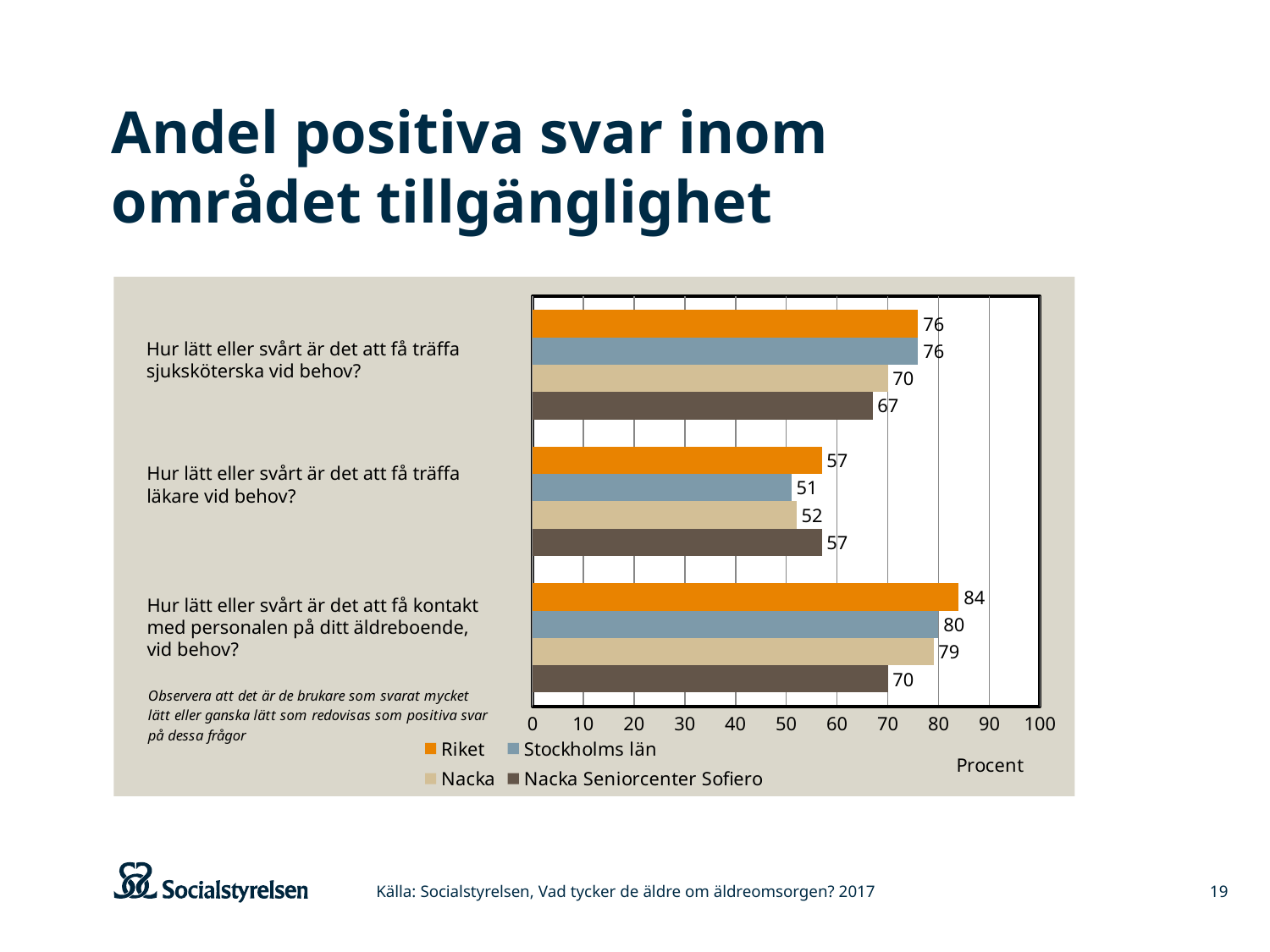
What is the value for Nacka Seniorcenter Sofiero on the question about meeting a nurse when needed ("...träffa sjuksköterska vid behov?")? 67 What is the value for Stockholms län on the question about meeting a doctor when needed ("...träffa läkare vid behov?")? 51 What is the value for Riket on the question about getting in contact with staff at the care home ("Hur lätt eller svårt är det att få kontakt med personalen på ditt äldreboende, vid behov?")? 84 Which series has the lowest value on the question about meeting a nurse when needed? Nacka Seniorcenter Sofiero What kind of chart is shown on the slide? Bar chart What unit is shown on the horizontal axis of the chart? Procent Is the value for Nacka on the question about contact with staff at the care home greater or less than 70? greater How many questions (categories) are shown in the chart? 3 On the question about meeting a doctor when needed, which is larger: the value for Nacka or the value for Stockholms län? Nacka What is the difference between Riket and Nacka Seniorcenter Sofiero on the question about contact with staff at the care home? 14 Which series has the highest value on the question about contact with staff at the care home? Riket How many series does the legend list? 4